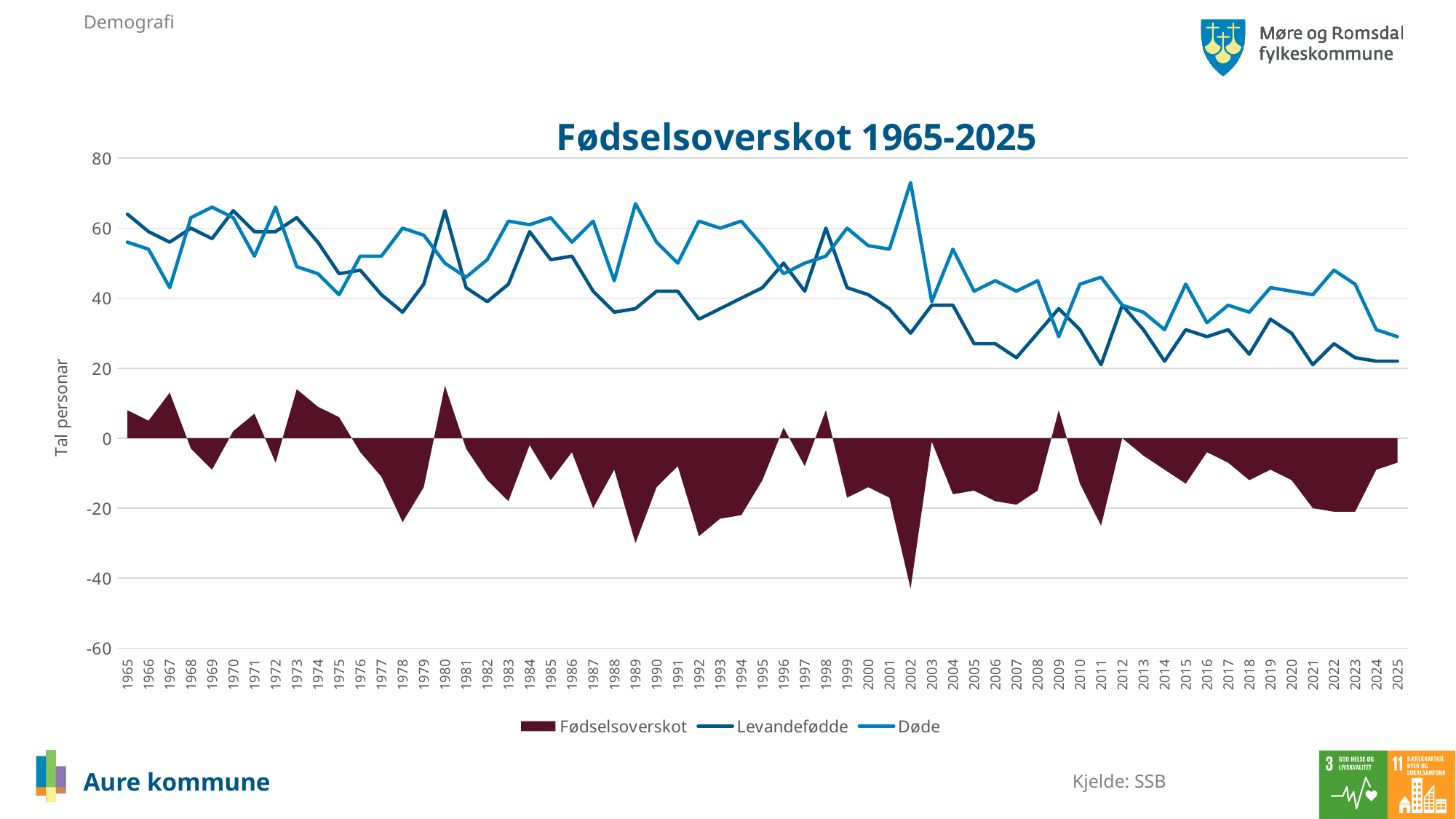
Is the value for Døde in 2002 greater or less than 60? greater Is the value for Fødselsoverskot in 2002 greater or less than -20? less How many years are shown along the x axis of the chart? 61 In 2002, which series has the larger value, Levandefødde or Døde? Døde What is the title of the chart? Fødselsoverskot 1965-2025 Is the value for Levandefødde in 2025 greater or less than 40? less In which year does the Døde series reach its highest value? 2002 How many series does the chart legend list? 3 In which year does the Fødselsoverskot series reach its lowest value? 2002 In 1965, which series has the larger value, Levandefødde or Døde? Levandefødde Does the Levandefødde series generally rise or fall from 1965 to 2025? fall What is the label on the vertical axis of the chart? Tal personar